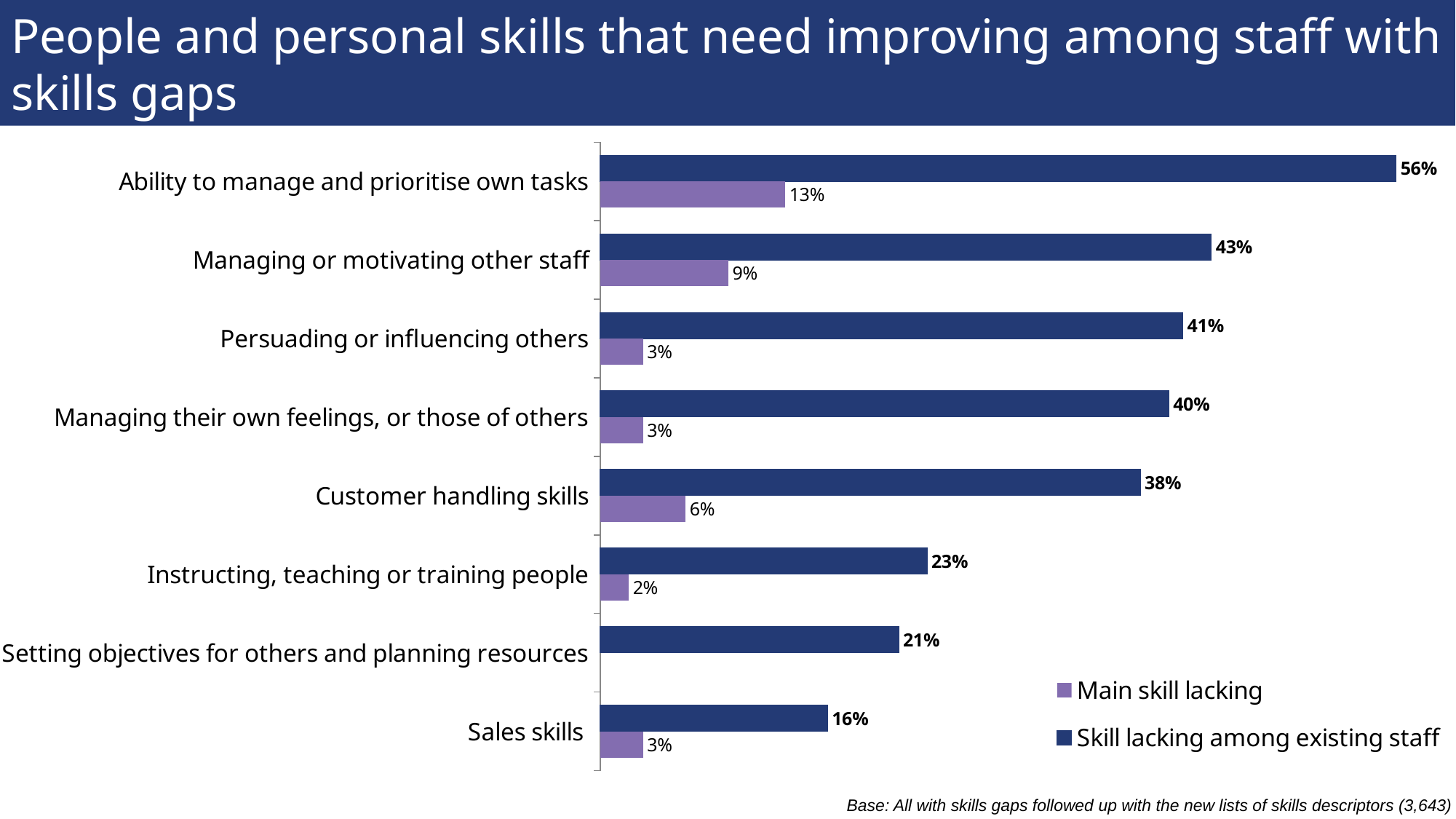
How many series does the legend list? 2 What is the value for 'Skill lacking among existing staff' for 'Ability to manage and prioritise own tasks'? 56% What is the value for 'Main skill lacking' for 'Instructing, teaching or training people'? 2% What is the difference between the 'Skill lacking among existing staff' values for 'Managing or motivating other staff' and 'Sales skills'? 27% What is the value for 'Skill lacking among existing staff' for 'Customer handling skills'? 38% Which series is shown in purple? Main skill lacking Which is larger for 'Main skill lacking': 'Ability to manage and prioritise own tasks' or 'Customer handling skills'? Ability to manage and prioritise own tasks What kind of chart is shown on the slide? Bar chart What is the value for 'Main skill lacking' for 'Managing or motivating other staff'? 9% How many categories are shown on the chart? 8 Which category has the highest value for 'Skill lacking among existing staff'? Ability to manage and prioritise own tasks Which category has the lowest value for 'Skill lacking among existing staff'? Sales skills